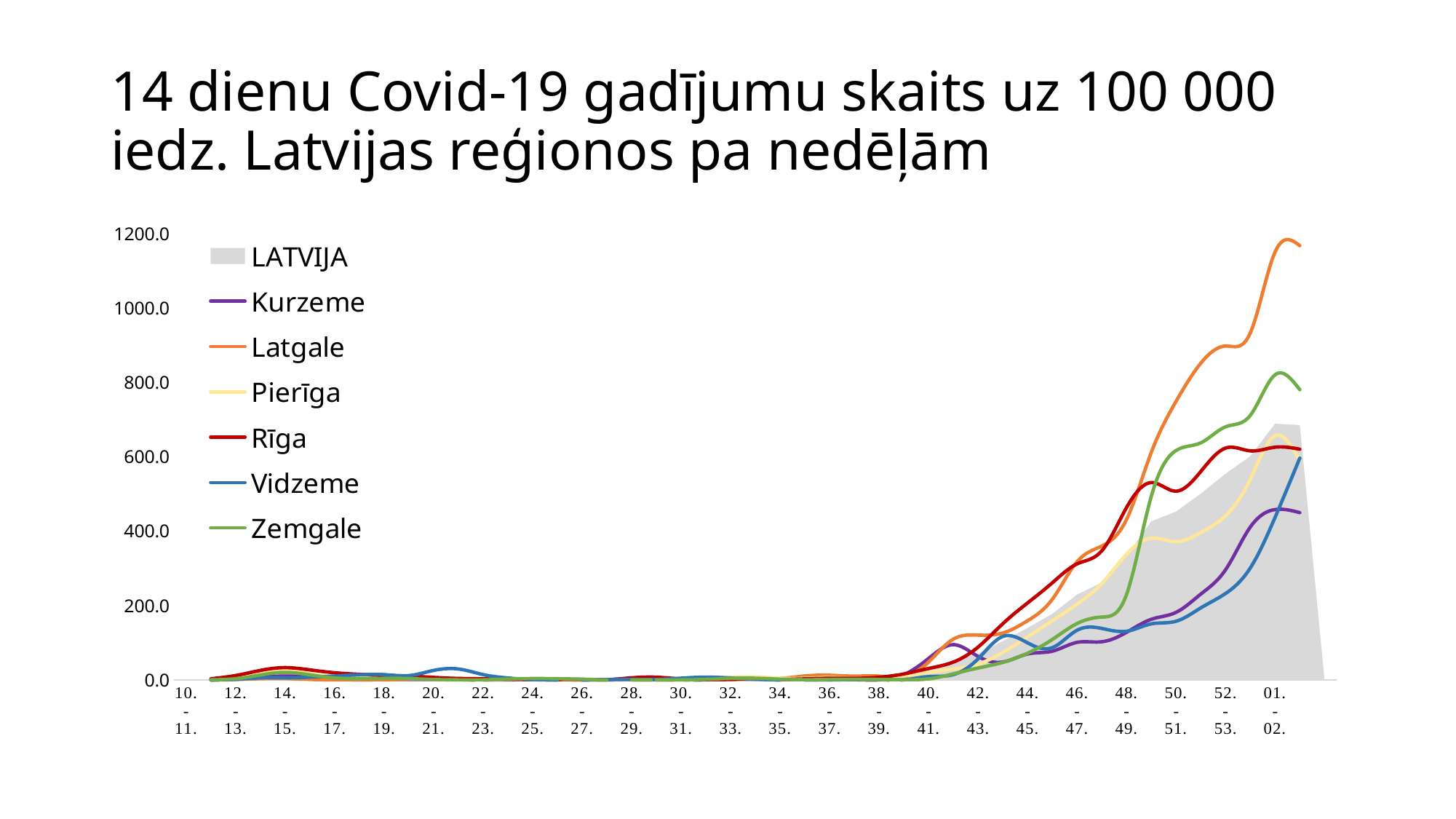
At week 01.-02., which is higher: Latgale or Rīga? Latgale Is the value for Pierīga at week 50.-51. greater or less than 600.0? less What kind of chart is shown on the slide? line chart Is the peak value for Latgale greater or less than 1000.0? greater What is the highest value shown on the vertical axis? 1200.0 How many series does the legend list? 7 Which series is drawn as a shaded grey area rather than a line? LATVIJA Do the values for Latgale rise or fall between week 40.-41. and week 01.-02.? rise At week 48.-49., which is higher: Rīga or Vidzeme? Rīga Is the peak value for Zemgale greater or less than 800.0? greater Which region has the highest value at the right end of the chart (week 01.-02.)? Latgale